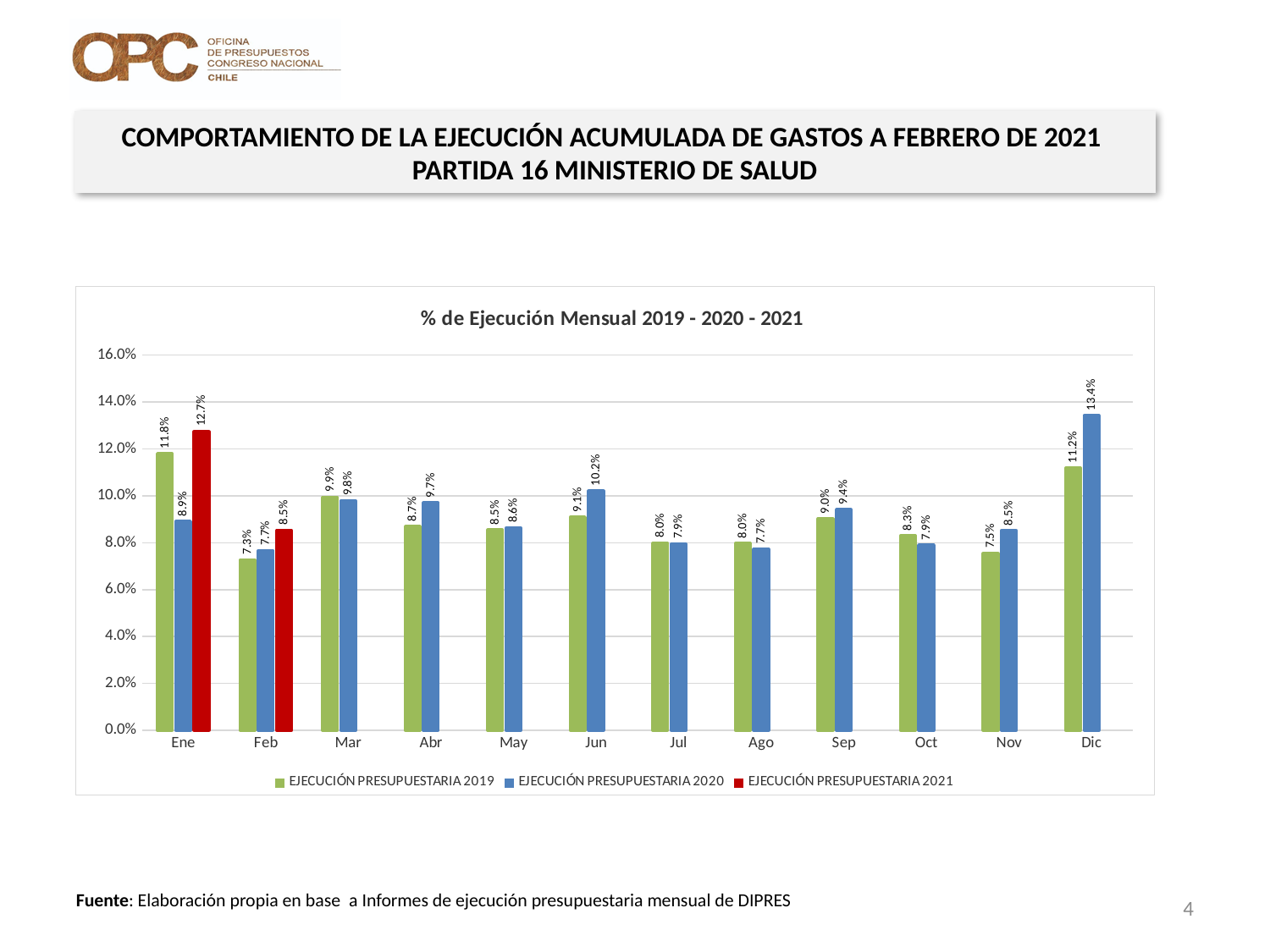
What is the value for EJECUCIÓN PRESUPUESTARIA 2020 in Jun? 10.2% In which month is the EJECUCIÓN PRESUPUESTARIA 2019 value lowest? Feb In which month is the EJECUCIÓN PRESUPUESTARIA 2020 value highest? Dic What is the difference between the 2021 and 2020 values in Feb? 0.8% How many months are shown on the x axis? 12 Which is larger in Ene: the 2019 value or the 2020 value? 2019 How many series does the legend list? 3 What is the difference between the 2020 and 2019 values in Dic? 2.2% What is the value for EJECUCIÓN PRESUPUESTARIA 2021 in Ene? 12.7% What type of chart is shown on the slide? bar chart What is the value for EJECUCIÓN PRESUPUESTARIA 2019 in Nov? 7.5% What is the title of the chart? % de Ejecución Mensual 2019 - 2020 - 2021